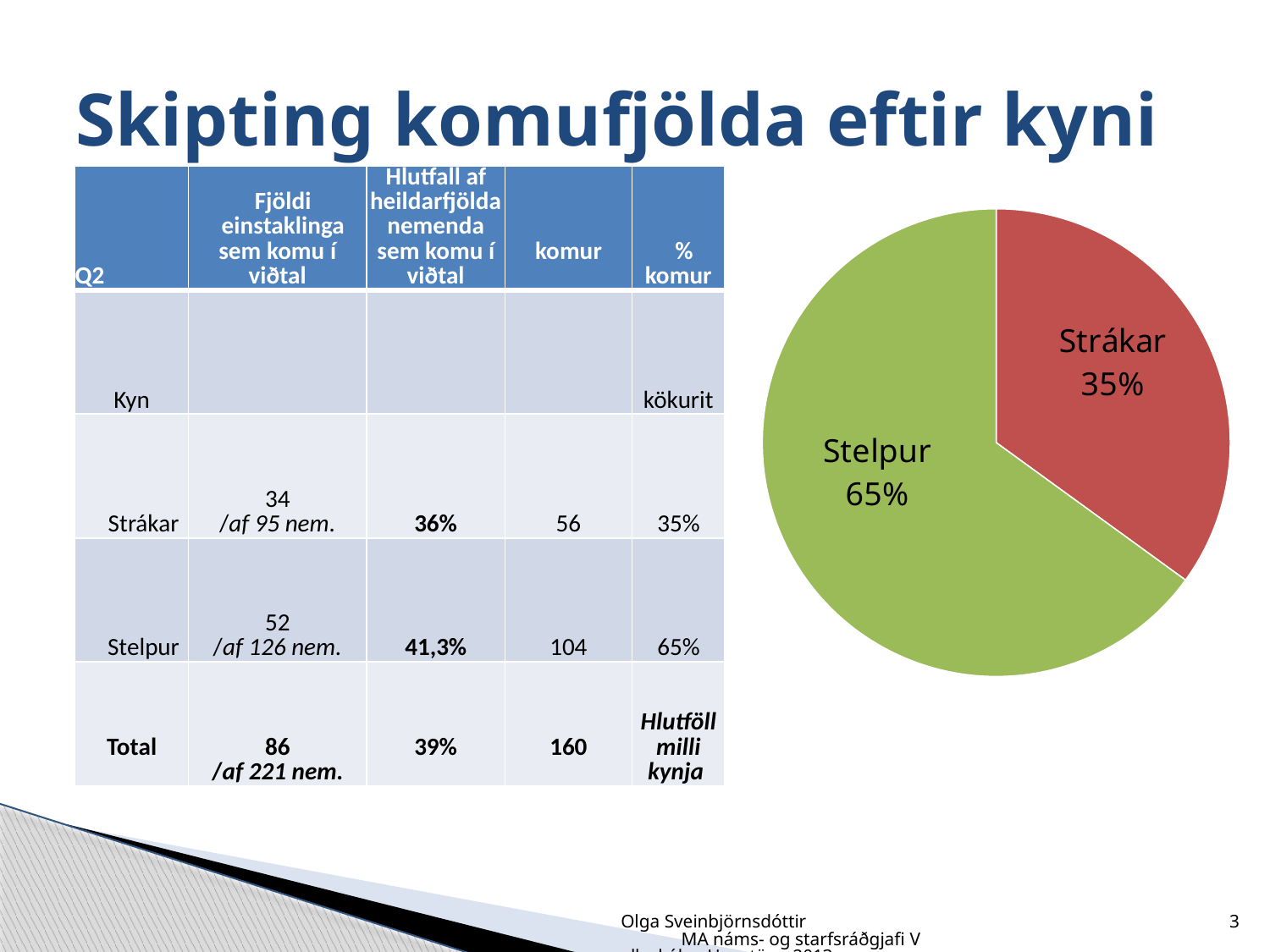
Which slice of the pie chart is the largest? Stelpur What colour is the Stelpur slice in the pie chart? green How many slices does the pie chart have? 2 Which slice of the pie chart is the smallest? Strákar Which is larger in the pie chart, Strákar or Stelpur? Stelpur What kind of chart is shown on the slide? pie chart What colour is the Strákar slice in the pie chart? red What share of the pie chart does Strákar have? 35% Is the Strákar slice of the pie chart greater or less than half of the pie? less By how many percentage points does the Stelpur slice exceed the Strákar slice? 30 What share of the pie chart does Stelpur have? 65%